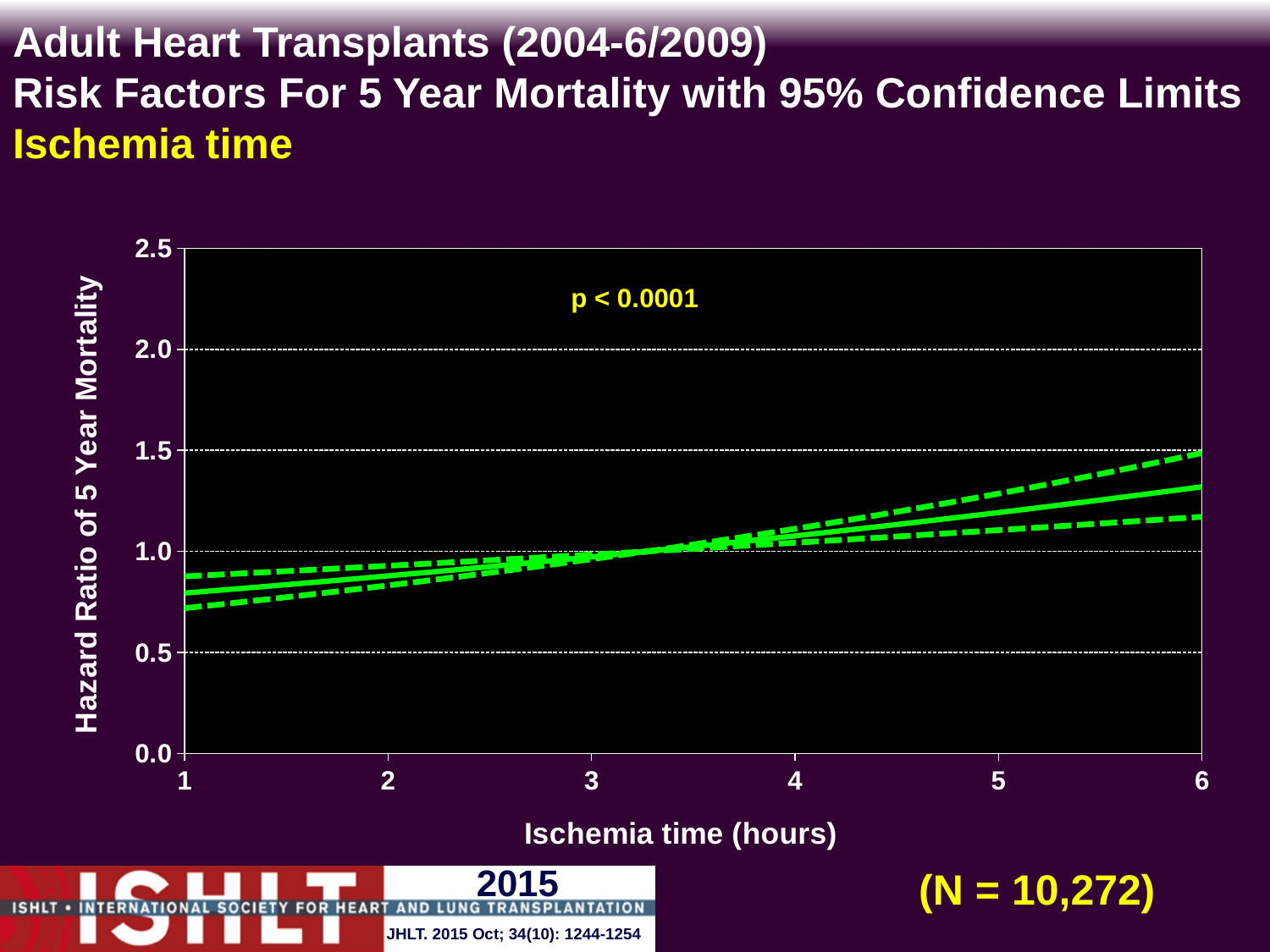
How many tick marks are labelled on the x axis (ischemia time)? 6 What kind of chart is shown on the slide? line chart How many lines are plotted on the chart, including the confidence limit lines? 3 What p-value is printed on the chart? p < 0.0001 Is the hazard ratio of 5 year mortality at an ischemia time of 1 hour greater or less than 1.0? less Is the hazard ratio of 5 year mortality at an ischemia time of 6 hours greater or less than 1.0? greater Is the hazard ratio of 5 year mortality higher at an ischemia time of 6 hours or at 2 hours? 6 hours What sample size (N) is shown on the slide? N = 10,272 Does the hazard ratio of 5 year mortality rise or fall as ischemia time increases from 1 to 6 hours? rise Is the hazard ratio of 5 year mortality at an ischemia time of 6 hours greater or less than 1.5? less What is the label of the y axis? Hazard Ratio of 5 Year Mortality